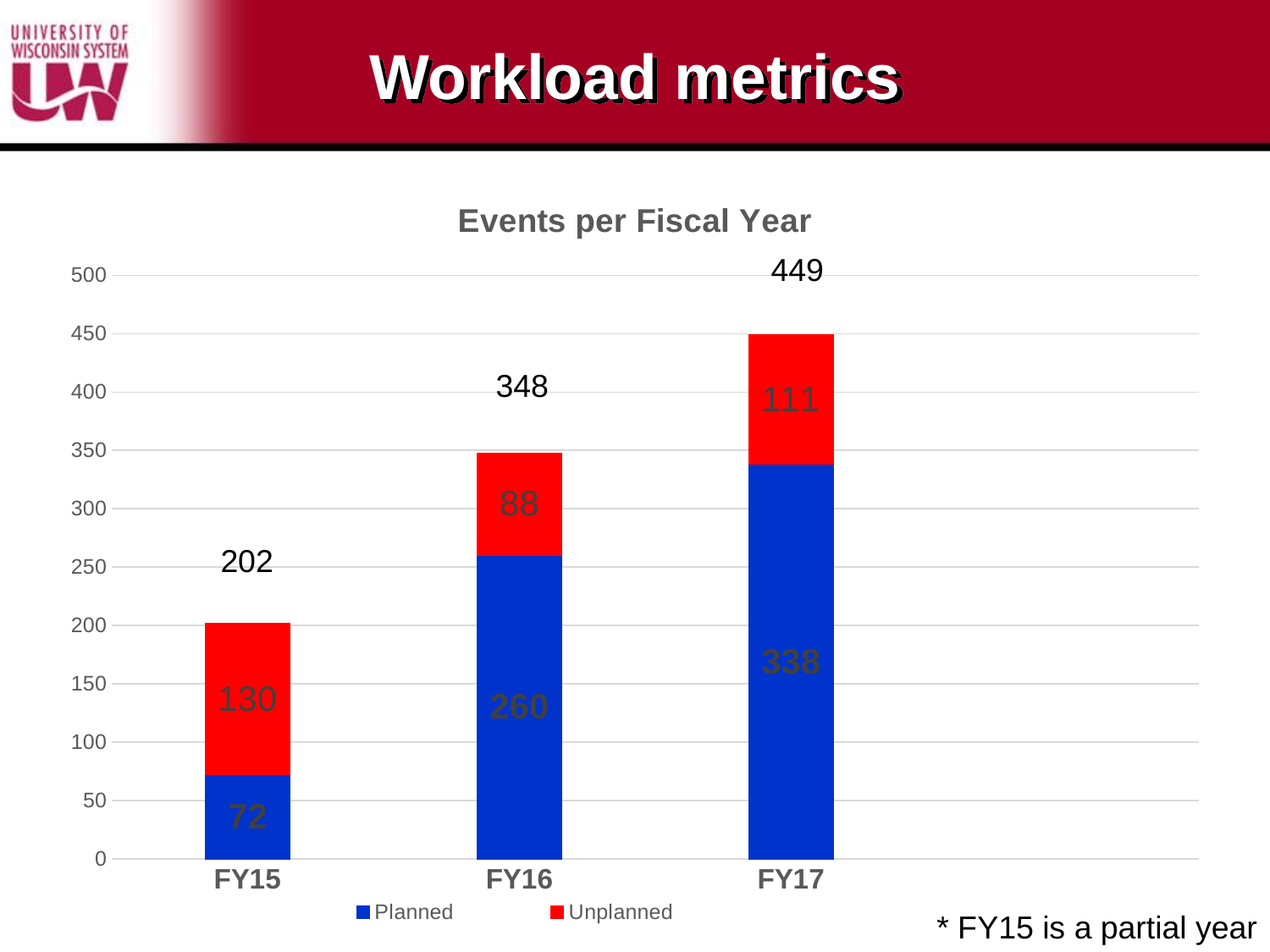
What is the Unplanned value for FY15? 130 Which fiscal year has the lowest Planned value? FY15 What is the total of the stacked bar for FY17? 449 How many fiscal years are shown on the x axis? 3 What is the Planned value for FY16? 260 Which fiscal year has the highest total number of events? FY17 How many series does the legend list? 2 What kind of chart is shown? Stacked bar chart Which is larger, the Unplanned value for FY15 or the Unplanned value for FY16? FY15 What is the difference between the Planned values for FY17 and FY16? 78 What is the Unplanned value for FY17? 111 Do the total events rise or fall from FY15 to FY17? Rise